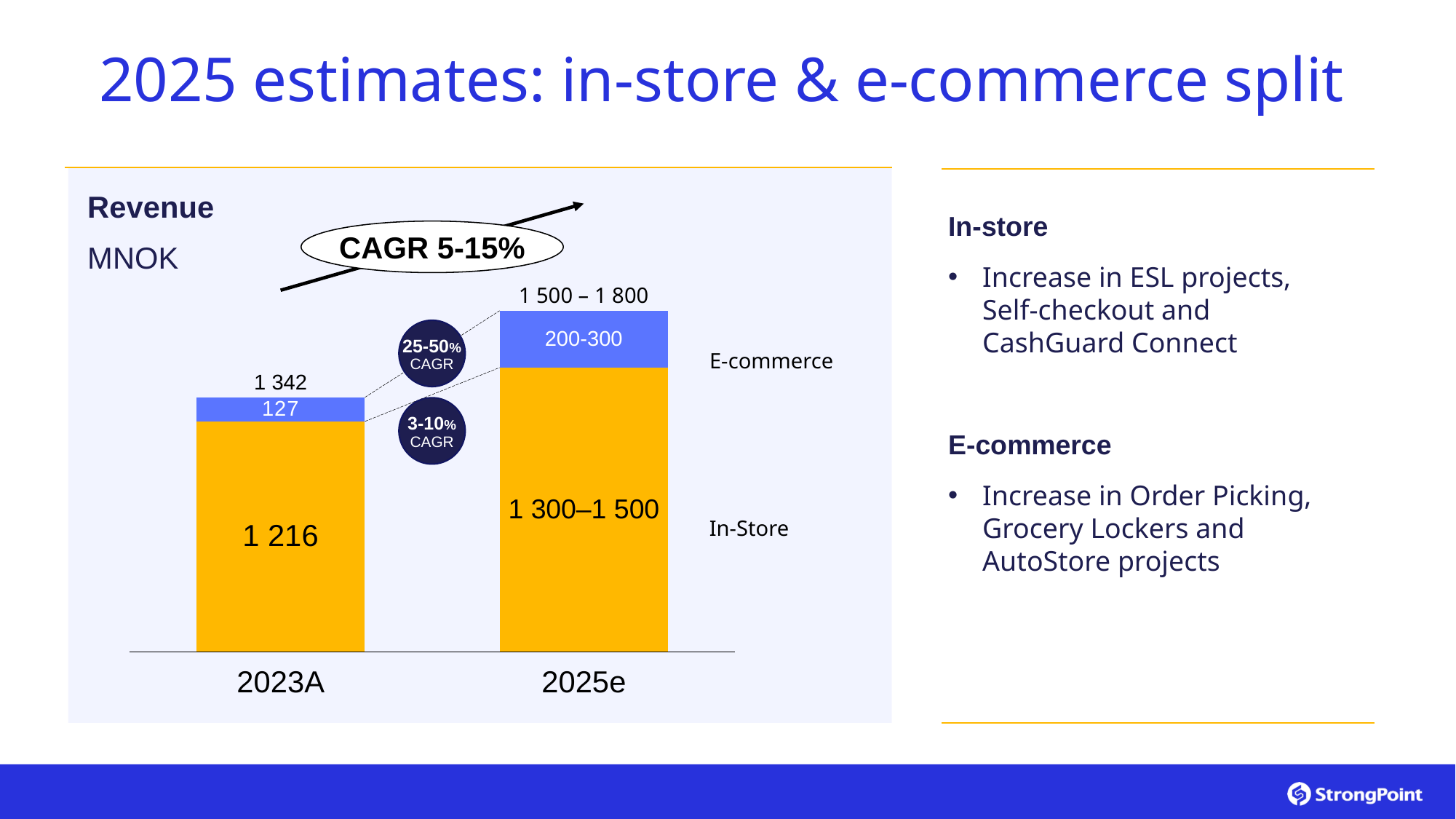
What is the difference between the In-Store and E-commerce values in 2023A? 1 089 What is the E-commerce revenue value for 2023A? 127 What is the In-Store revenue value for 2023A? 1 216 What is the estimated E-commerce revenue range for 2025e? 200-300 What is the total revenue shown above the 2023A bar? 1 342 What is the estimated In-Store revenue range for 2025e? 1 300–1 500 What is the total revenue range shown above the 2025e bar? 1 500 – 1 800 Which segment is larger in 2023A, In-Store or E-commerce? In-Store How many periods (bars) are shown on the x axis? 2 Does total revenue rise or fall from 2023A to 2025e? Rise What CAGR range is shown for the E-commerce segment between 2023A and 2025e? 25-50% What kind of chart is shown on the slide? Stacked bar chart